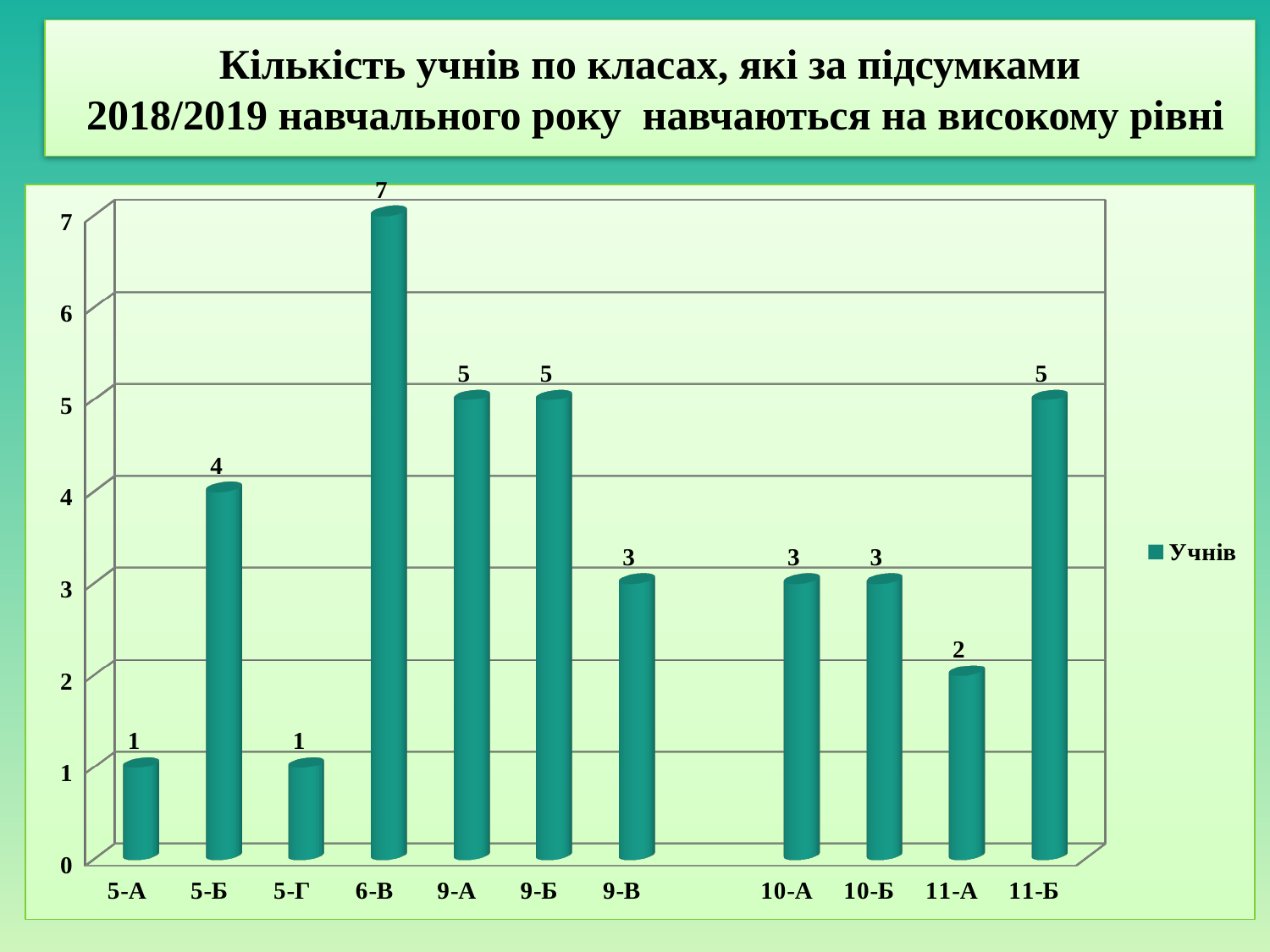
Which is larger, the value for 5-Б or the value for 10-А? 5-Б How many students are shown for class 6-В? 7 What is the value for class 11-А? 2 What is the value for class 5-Б? 4 How many bars are plotted on the chart? 11 What kind of chart is shown on the slide? Bar chart What is the difference between the values for 6-В and 9-В? 4 What is the difference between the values for 11-Б and 11-А? 3 How many series does the legend list? 1 What is the legend entry for the series? Учнів Which class has the highest number of students? 6-В Which is larger, the value for 9-А or the value for 9-В? 9-А